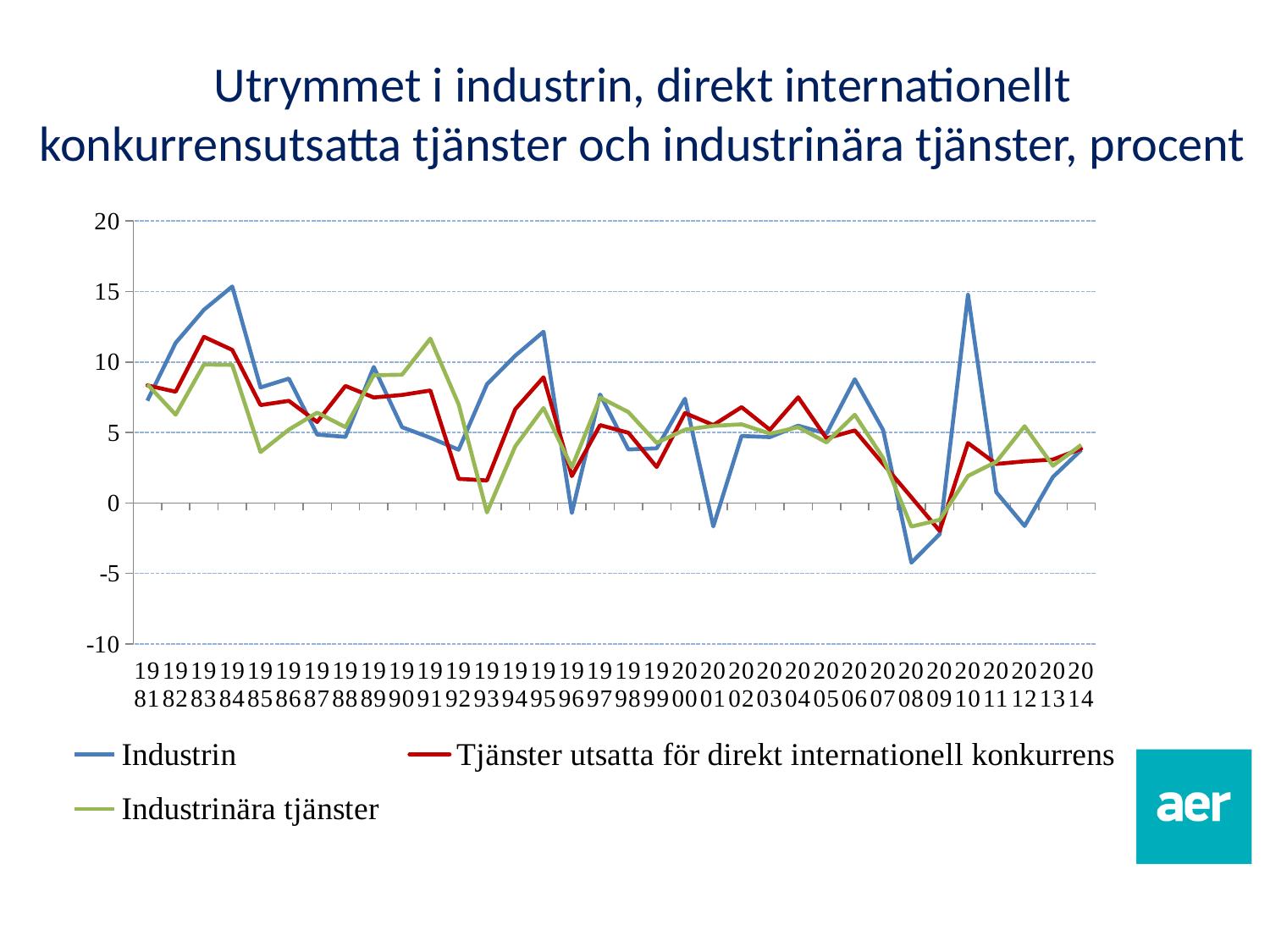
Is the value for Tjänster utsatta för direkt internationell konkurrens in 1993 greater or less than 5? less Is the value for Industrin in 1984 greater or less than 10? greater What kind of chart is shown on the slide? line chart Does the Industrin line rise or fall between 1981 and 1984? rise How many series does the legend list? 3 How many years are plotted along the x axis? 34 What is the highest value shown on the y axis? 20 In 1984, which is larger: Industrin or Tjänster utsatta för direkt internationell konkurrens? Industrin In which year does Industrin reach its lowest value? 2008 Is the value for Industrin in 2008 greater or less than 0? less Which series is drawn in blue? Industrin